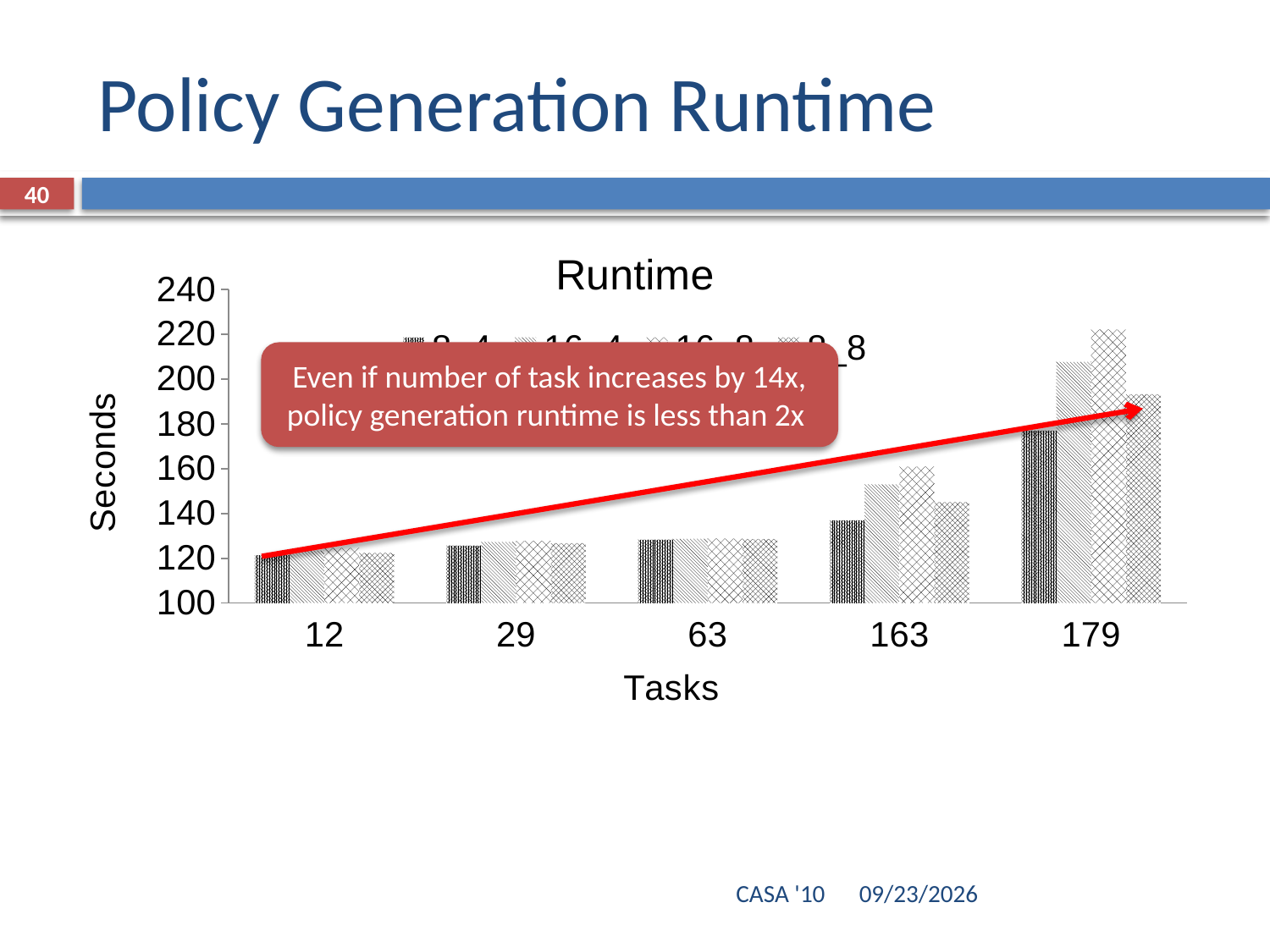
Which has higher runtime bars in the Runtime chart: 12 tasks or 179 tasks? 179 What is the title of the chart? Runtime How many task-count categories are shown on the x axis of the Runtime chart? 5 What is the label of the y axis of the chart? Seconds Are the runtime bars for 12 tasks greater or less than 140 seconds? less Which task count has the lowest runtime bars in the Runtime chart? 12 Is the tallest bar for 179 tasks greater or less than 200 seconds? greater What kind of chart is shown on the slide? bar chart Do the runtime values rise or fall as the number of tasks increases along the x axis? rise How many series does the legend of the Runtime chart list? 4 Which task count has the highest runtime bars in the Runtime chart? 179 Are the runtime bars for 63 tasks greater or less than 140 seconds? less